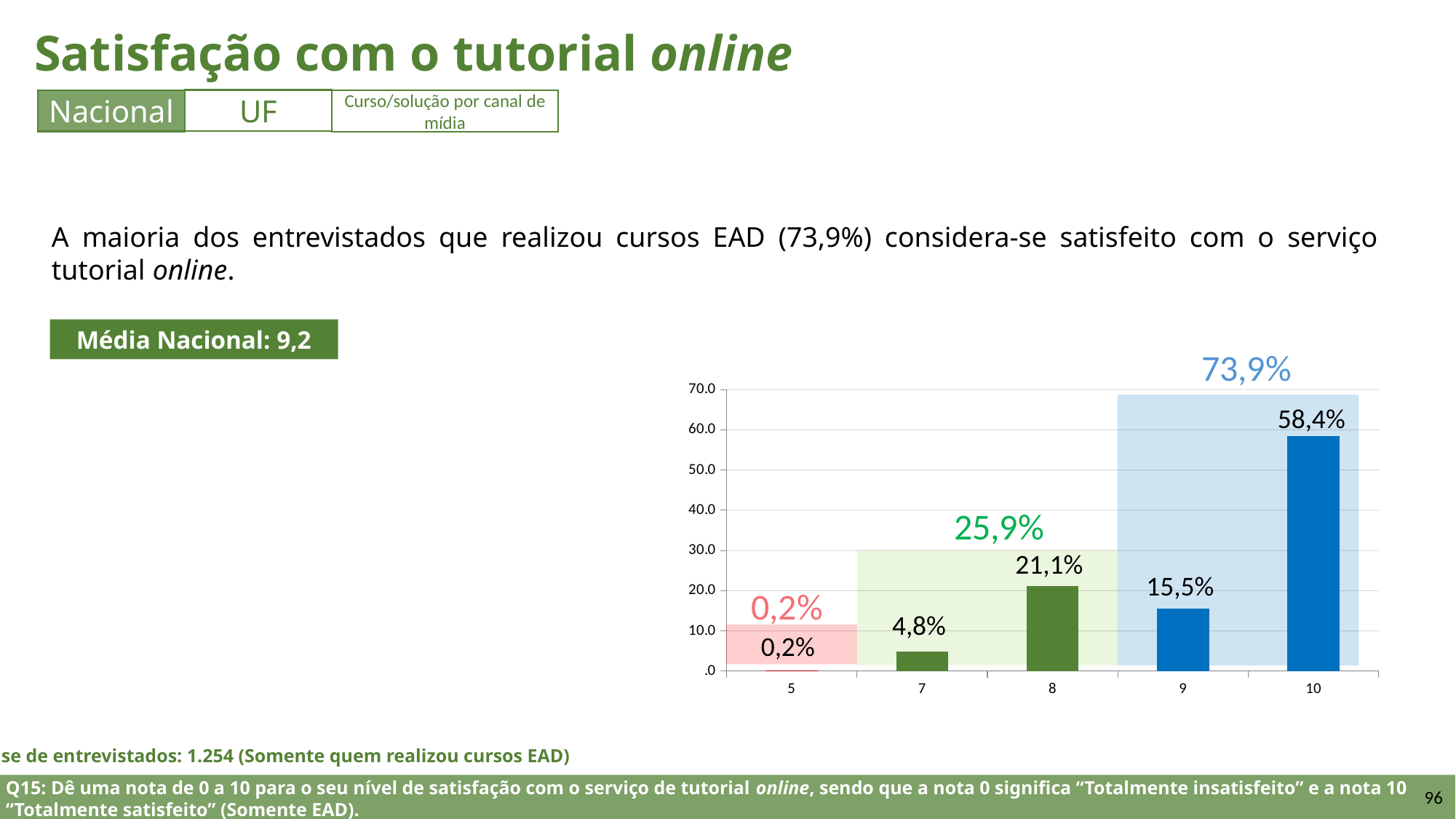
What is the value for score 8? 21,1% Which is larger, the value for score 8 or the value for score 9? score 8 Which score has the lowest value? 5 What is the value for score 7? 4,8% What is the value for score 10? 58,4% What kind of chart is shown on the slide? bar chart What is the value for score 9? 15,5% How many score categories are shown on the x axis? 5 Which score has the highest value? 10 Is the value for score 10 greater or less than 50? greater What combined percentage is shown above the shaded area covering scores 9 and 10? 73,9% What is the difference between the values for score 10 and score 9? 42,9%